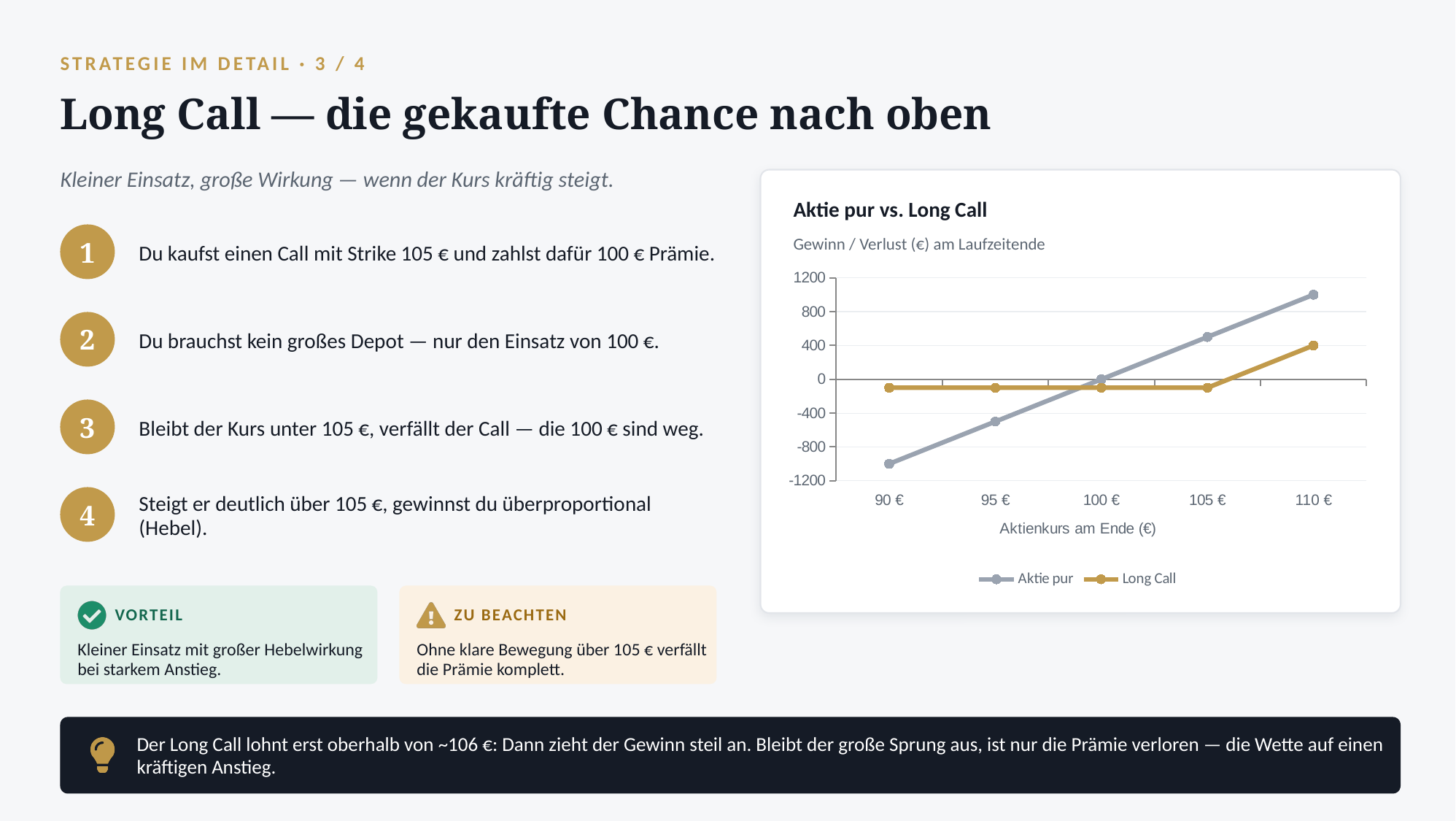
At which stock price does the Aktie pur series reach its lowest value? 90 € What is the label of the x axis of the chart? Aktienkurs am Ende (€) At 110 €, which series has the higher value, Aktie pur or Long Call? Aktie pur How many stock price points are shown along the x axis of the chart? 5 What is the title of the chart? Aktie pur vs. Long Call What kind of chart is shown on the slide? Line chart Is the value for Aktie pur at 90 € greater or less than -800? less Does the Aktie pur line rise or fall as the stock price increases along the x axis? Rises Is the value for Aktie pur at 110 € greater or less than 800? greater Is the value for Long Call at 95 € greater or less than 0? less At 90 €, which series has the higher value, Aktie pur or Long Call? Long Call How many series does the chart legend list? 2